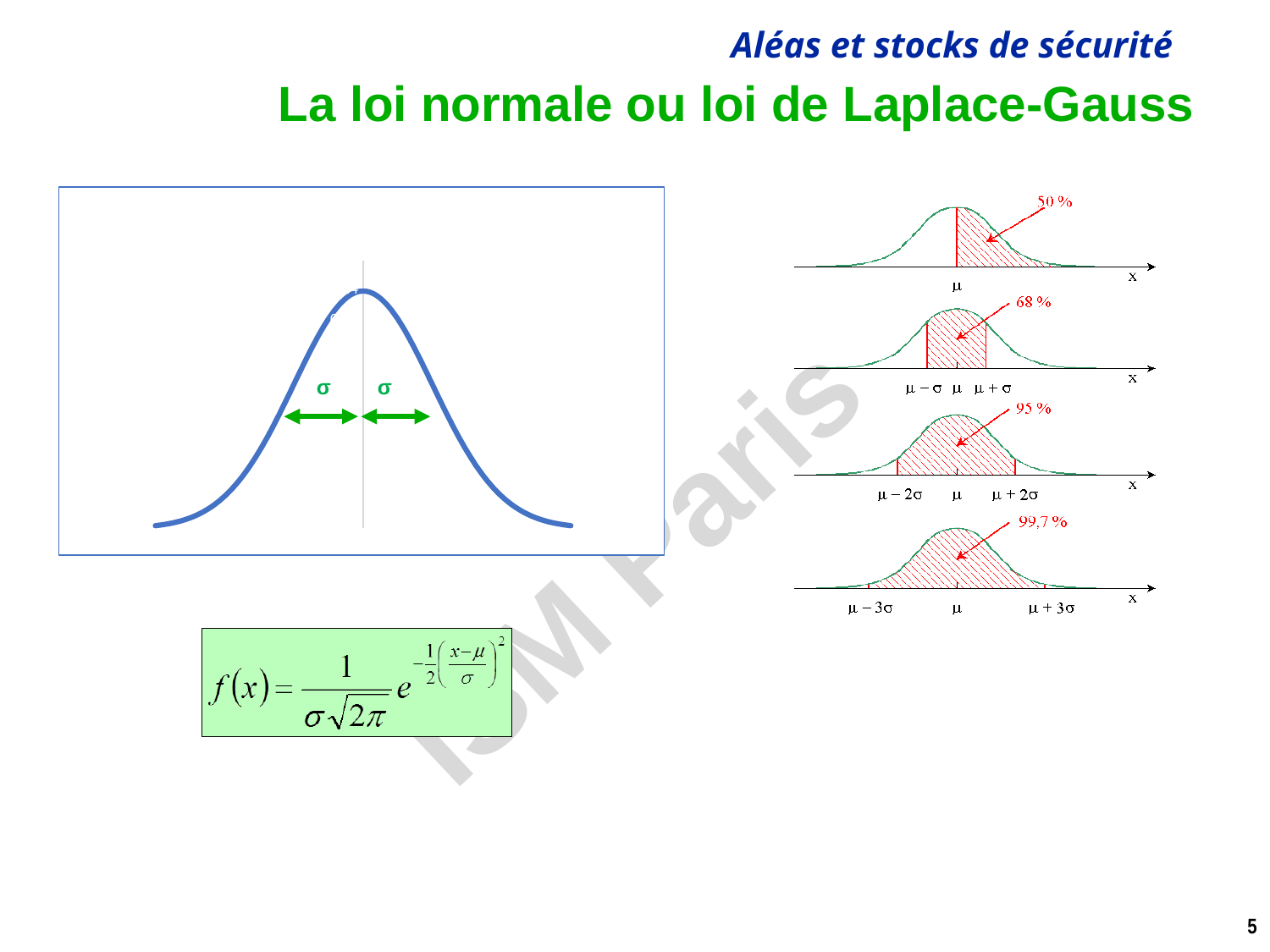
Among the right-hand diagrams, which diagram shows the smallest shaded percentage? the top one (50 %) In the right-hand diagrams, what percentage of the area is shaded between μ − 3σ and μ + 3σ? 99,7 % In the left chart, what symbol labels the two green arrows on either side of the centre line? σ What kind of chart is shown in the large box on the left of the slide? line chart In the right-hand diagrams, what percentage of the area is shaded between μ − 2σ and μ + 2σ? 95 % How many small distribution diagrams are stacked on the right side of the slide? 4 In the right-hand diagrams, what percentage of the area is shaded between μ − σ and μ + σ? 68 % In the right-hand diagrams, what is the difference between the percentage for μ ± 2σ and the percentage for μ ± σ? 27 % In the topmost right-hand diagram, what percentage is shown for the shaded area to the right of μ? 50 % In the left chart, does the curve rise or fall as x moves from the centre line to the right? fall Among the right-hand diagrams, which interval has the largest shaded percentage? μ − 3σ to μ + 3σ In the right-hand diagrams, which is larger: the shaded percentage for μ ± σ or for μ ± 2σ? μ ± 2σ